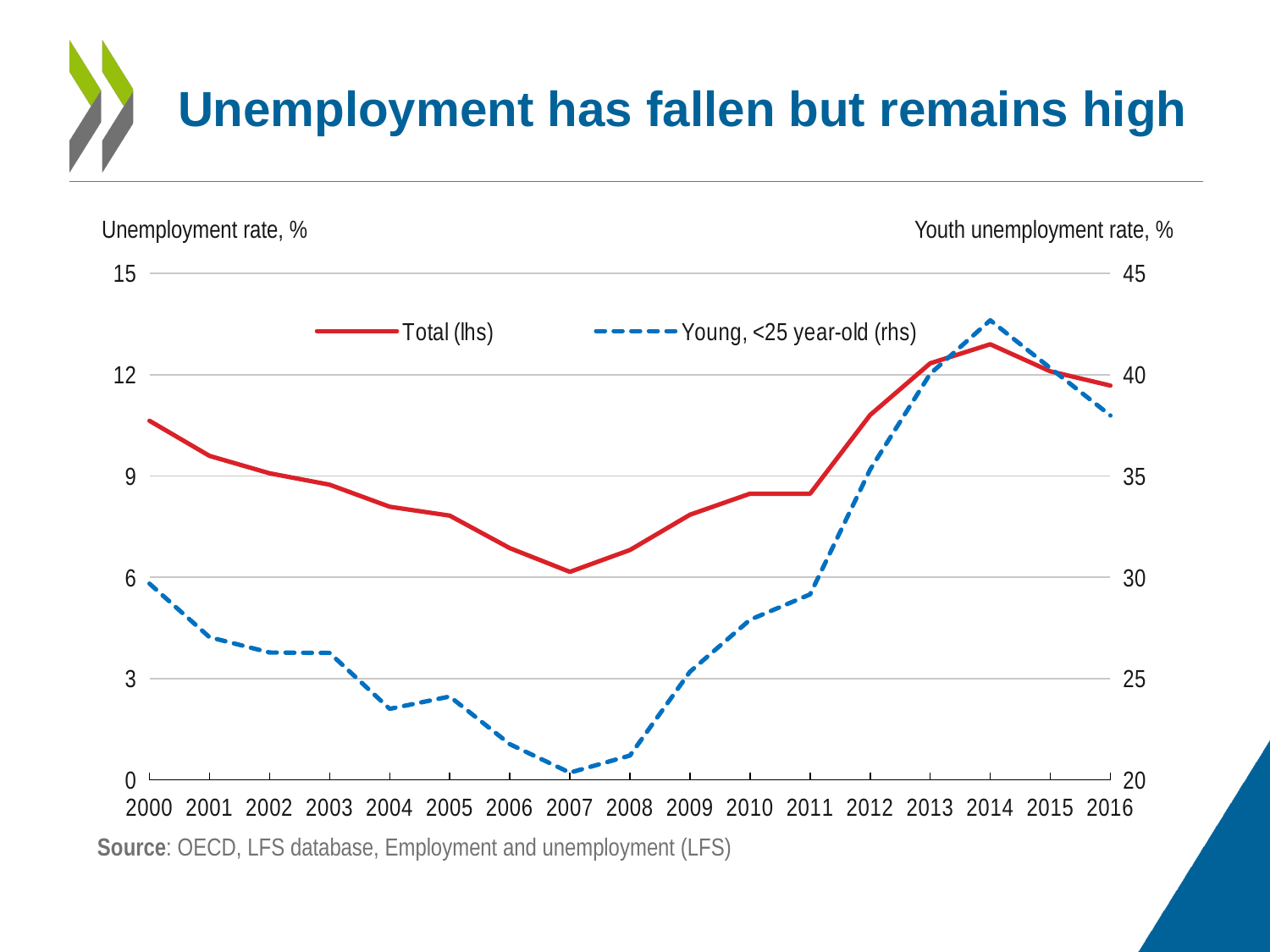
How many series does the legend list? 2 In which year is the Young, <25 year-old (rhs) series at its lowest? 2007 In which year does the Total (lhs) unemployment rate reach its highest point? 2014 What is the title of the slide? Unemployment has fallen but remains high Is the Total (lhs) unemployment rate in 2000 greater or less than 9? greater In which year does the Young, <25 year-old (rhs) series peak? 2014 What kind of chart is shown on the slide? line chart Is the Young, <25 year-old (rhs) unemployment rate in 2014 greater or less than 40? greater How many years are shown along the x axis? 17 Does the Total (lhs) unemployment rate rise or fall between 2000 and 2007? fall Which is higher for the Young, <25 year-old (rhs) series: the value in 2000 or the value in 2016? 2016 In which year is the Total (lhs) unemployment rate at its lowest? 2007